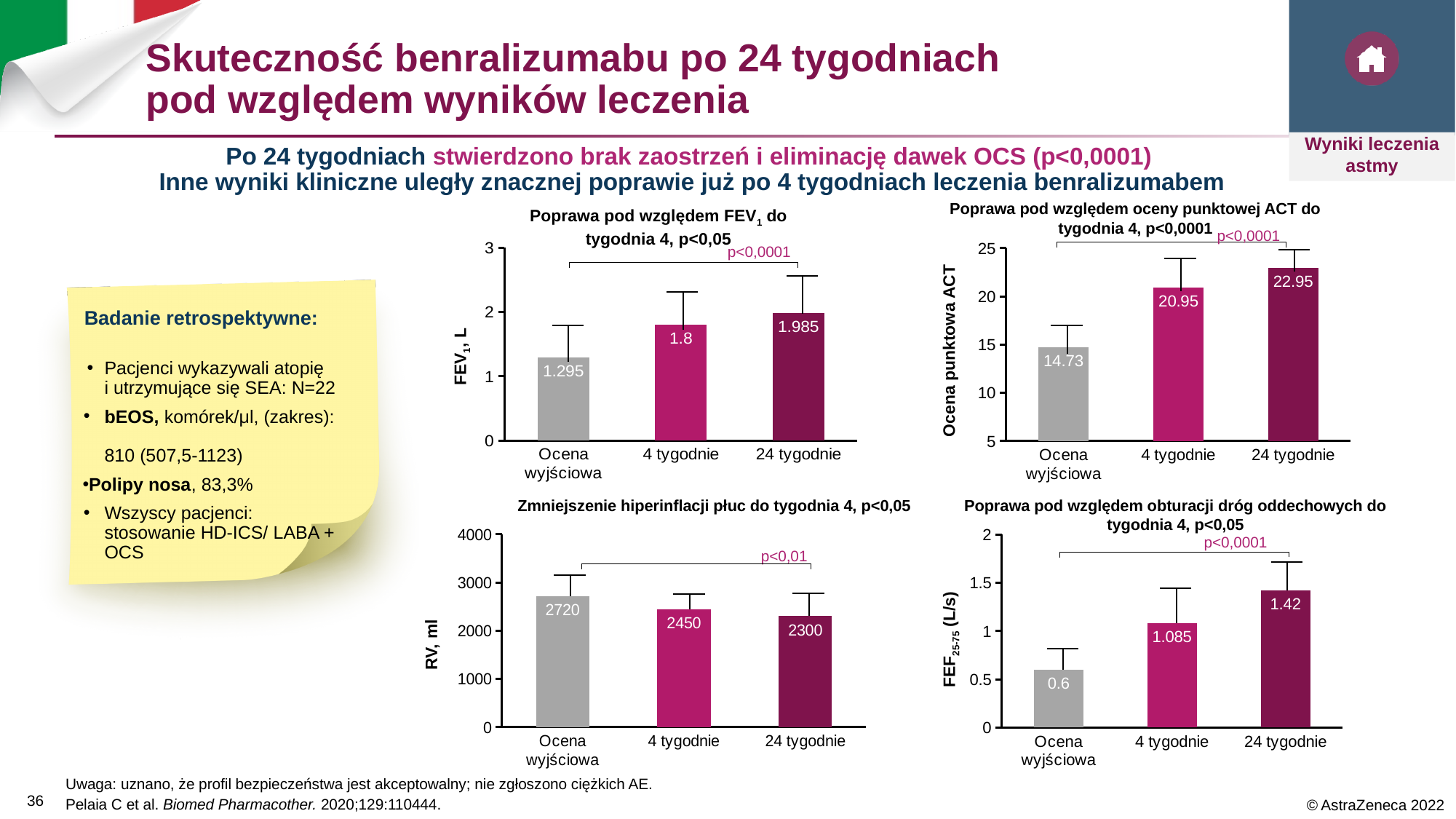
In the top-right chart (Poprawa pod względem oceny punktowej ACT), what is the difference between the 24 tygodnie and Ocena wyjściowa values? 8.22 In the bottom-left chart (Zmniejszenie hiperinflacji płuc), what is the value for 24 tygodnie? 2300 In the top-left chart (Poprawa pod względem FEV1), which category has the highest value? 24 tygodnie In the bottom-right chart (Poprawa pod względem obturacji dróg oddechowych), what is the value for 4 tygodnie? 1.085 In the top-left chart (Poprawa pod względem FEV1), what is the value for Ocena wyjściowa? 1.295 In the bottom-left chart (Zmniejszenie hiperinflacji płuc), what is the difference between the Ocena wyjściowa and 4 tygodnie values? 270 In the top-right chart (Poprawa pod względem oceny punktowej ACT), which category has the lowest value? Ocena wyjściowa In the bottom-right chart (Poprawa pod względem obturacji dróg oddechowych), which is larger, the value for Ocena wyjściowa or for 24 tygodnie? 24 tygodnie In the bottom-left chart (Zmniejszenie hiperinflacji płuc), do the values rise or fall from Ocena wyjściowa to 24 tygodnie? fall What kind of chart is the bottom-left chart (Zmniejszenie hiperinflacji płuc)? bar chart How many categories are shown on the x axis of the top-left chart (Poprawa pod względem FEV1)? 3 In the top-right chart (Poprawa pod względem oceny punktowej ACT), what is the value for 4 tygodnie? 20.95